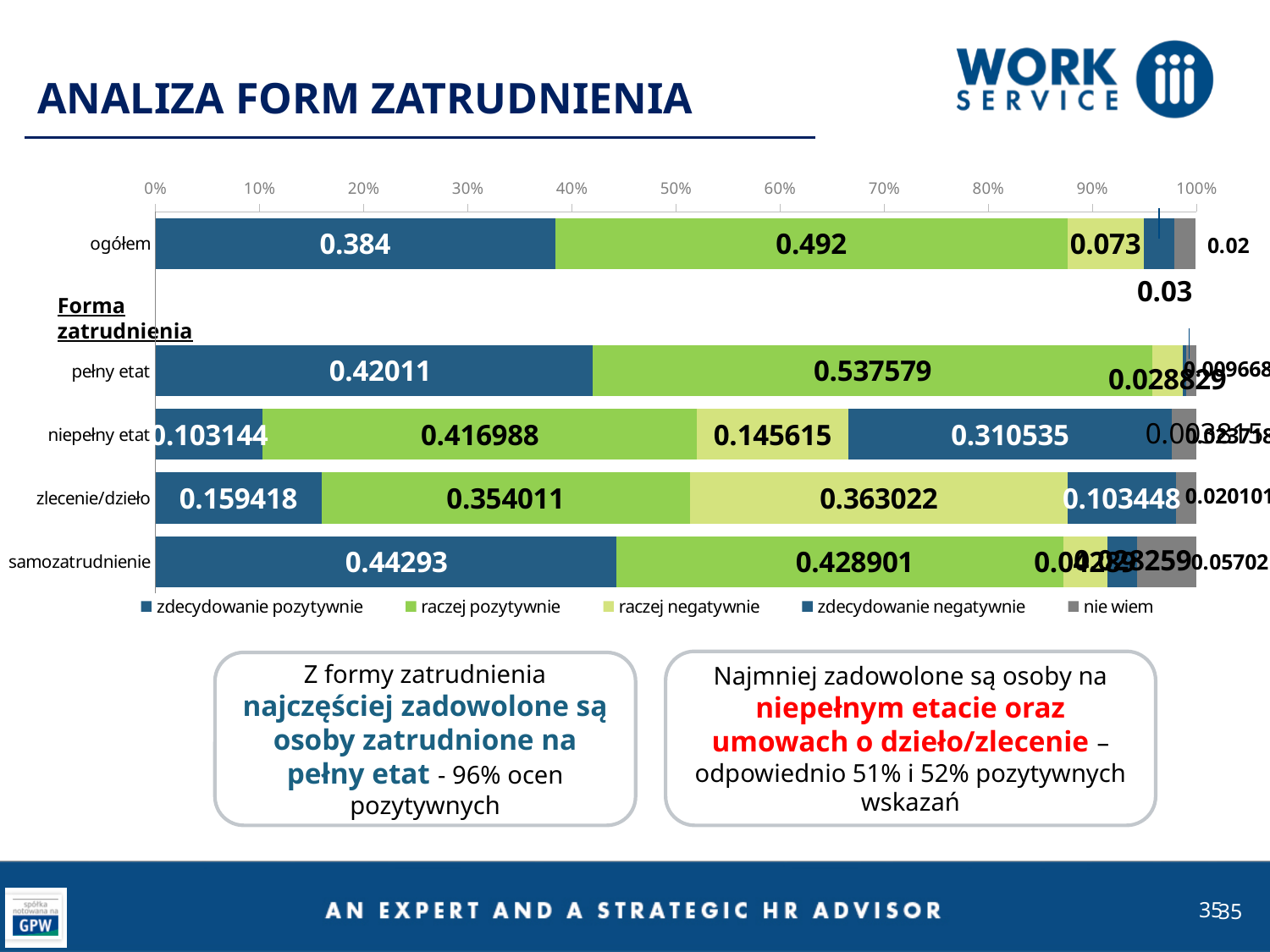
How many employment-form categories are plotted on the chart? 5 What is the value of 'zdecydowanie pozytywnie' for 'ogółem'? 0.384 For 'ogółem', which is larger: 'zdecydowanie pozytywnie' or 'raczej pozytywnie'? raczej pozytywnie Which category has the highest value for 'raczej pozytywnie'? pełny etat What is the value of 'raczej pozytywnie' for 'pełny etat'? 0.537579 What is the value of 'zdecydowanie pozytywnie' for 'samozatrudnienie'? 0.44293 How many series does the legend list? 5 What kind of chart is shown on the slide? bar chart What is the difference between 'raczej pozytywnie' and 'zdecydowanie pozytywnie' for 'ogółem'? 0.108 What is the value of 'zdecydowanie negatywnie' for 'niepełny etat'? 0.310535 What is the value of 'raczej negatywnie' for 'zlecenie/dzieło'? 0.363022 Which category has the lowest value for 'zdecydowanie pozytywnie'? niepełny etat